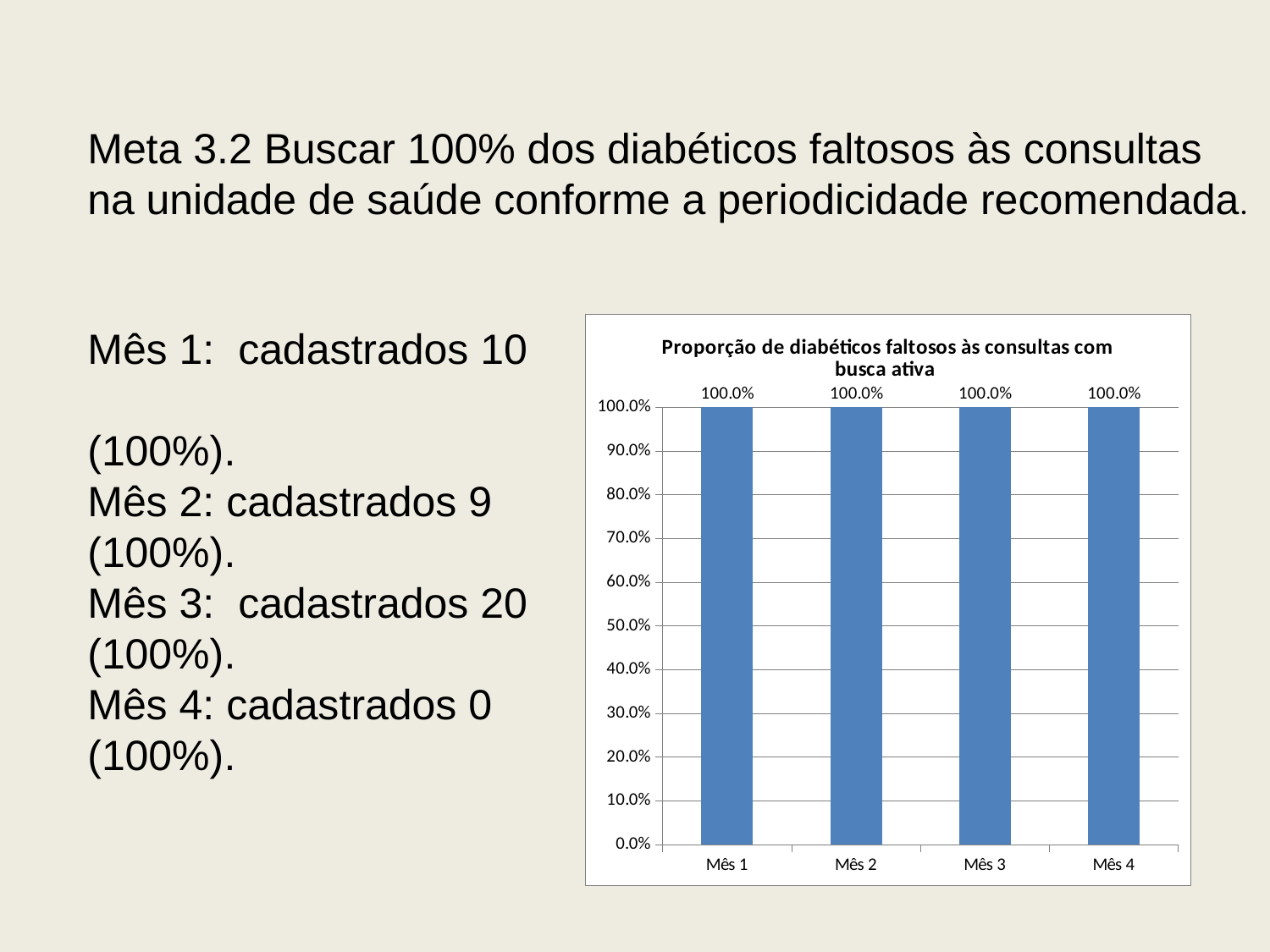
What is the value for Mês 4 in the chart? 100.0% What is the title of the chart? Proporção de diabéticos faltosos às consultas com busca ativa How many categories are shown on the x axis of the chart? 4 Do the values rise, fall or stay the same from Mês 1 to Mês 4? stay the same What is the difference between the values for Mês 1 and Mês 4? 0.0% What colour are the bars in the chart? blue Is the value for Mês 3 greater or less than 90.0%? greater What kind of chart is shown on the slide? bar chart What is the value for Mês 3 in the chart? 100.0% What is the value for Mês 2 in the chart? 100.0% What is the value for Mês 1 in the chart? 100.0%